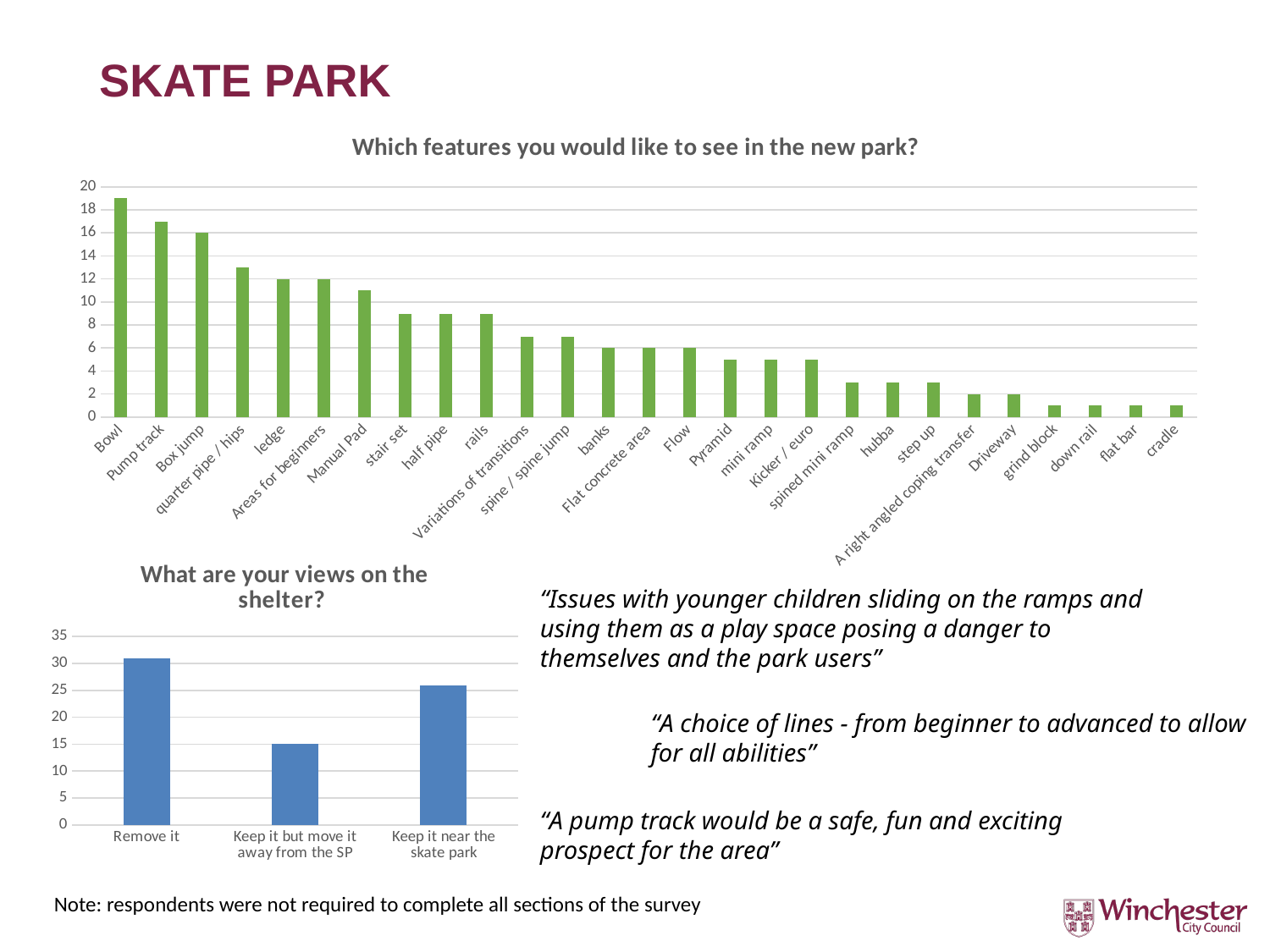
In the chart 'What are your views on the shelter?', which option received the most responses? Remove it In the chart 'What are your views on the shelter?', is the value for 'Remove it' greater or less than 30? greater In the chart 'What are your views on the shelter?', which option received the fewest responses? Keep it but move it away from the SP In the chart 'Which features you would like to see in the new park?', how many feature categories are shown on the x axis? 27 In the chart 'Which features you would like to see in the new park?', which feature received the highest number of responses? Bowl In the chart 'Which features you would like to see in the new park?', what is the value for ledge? 12 In the chart 'Which features you would like to see in the new park?', what is the value for Box jump? 16 What type of chart is 'What are your views on the shelter?' bar chart In the chart 'Which features you would like to see in the new park?', is the value for Bowl greater or less than 18? greater In the chart 'Which features you would like to see in the new park?', which has a larger value, Pump track or Manual Pad? Pump track In the chart 'Which features you would like to see in the new park?', do the values generally rise or fall from left to right? fall In the chart 'What are your views on the shelter?', what is the value for 'Keep it but move it away from the SP'? 15